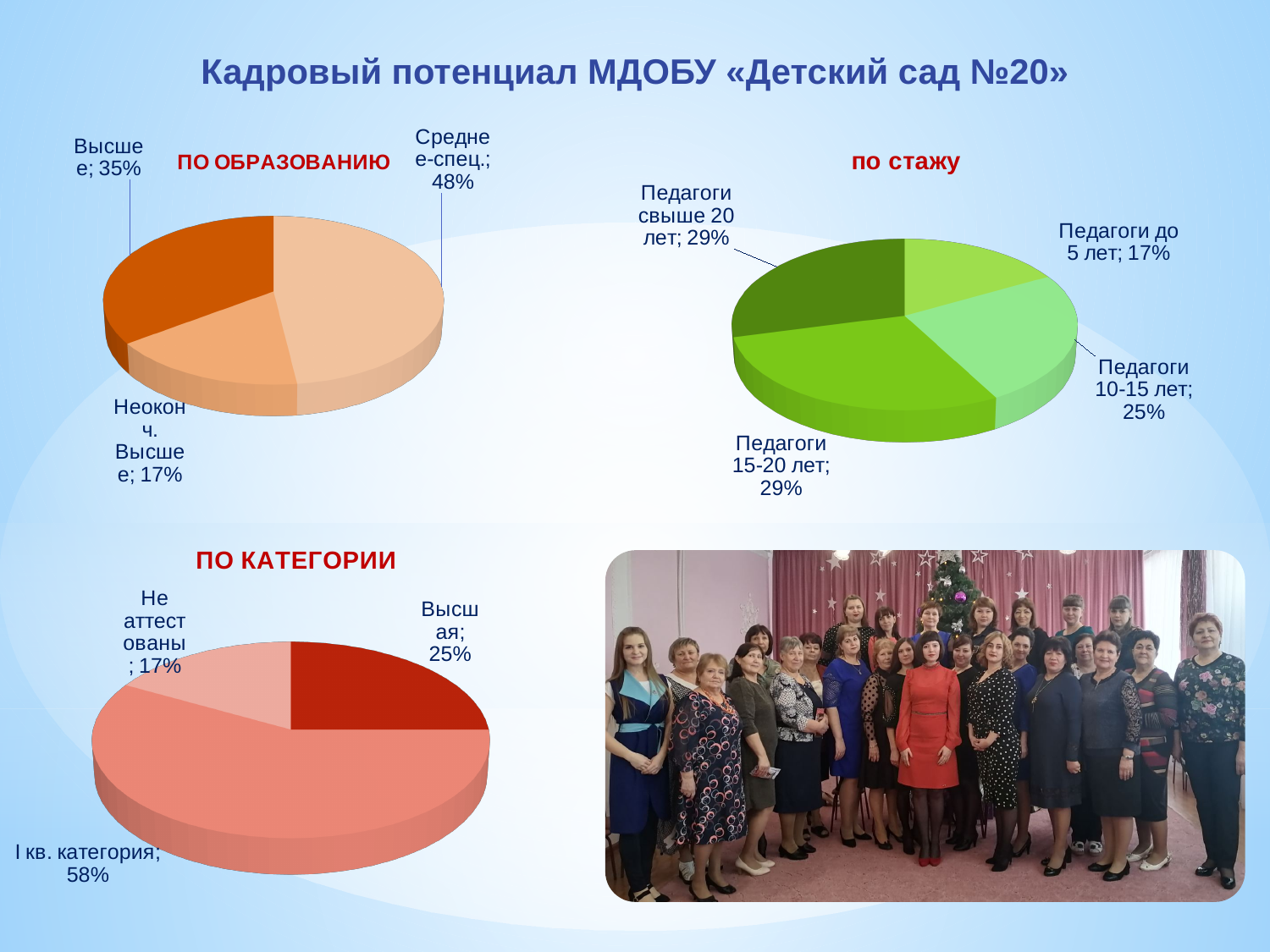
In the "ПО ОБРАЗОВАНИЮ" chart, what share is labelled "Среднее-спец."? 48% How many charts are shown on the slide? 3 In the "ПО ОБРАЗОВАНИЮ" chart, what is the difference between the "Среднее-спец." and "Высшее" shares? 13% In the "по стажу" chart, which is larger: "Педагоги 10-15 лет" or "Педагоги до 5 лет"? Педагоги 10-15 лет What type of chart is the "ПО КАТЕГОРИИ" chart? Pie chart In the "ПО ОБРАЗОВАНИЮ" chart, which category has the smallest share? Неоконч. Высшее In the "ПО КАТЕГОРИИ" chart, what is the difference between "I кв. категория" and "Не аттестованы"? 41% In the "ПО КАТЕГОРИИ" chart, what share is labelled "Высшая"? 25% In the "по стажу" chart, what share is labelled "Педагоги до 5 лет"? 17% In the "по стажу" chart, what is the combined share of "Педагоги 15-20 лет" and "Педагоги свыше 20 лет"? 58% How many slices does the "по стажу" chart have? 4 In the "ПО КАТЕГОРИИ" chart, which category has the largest share? I кв. категория